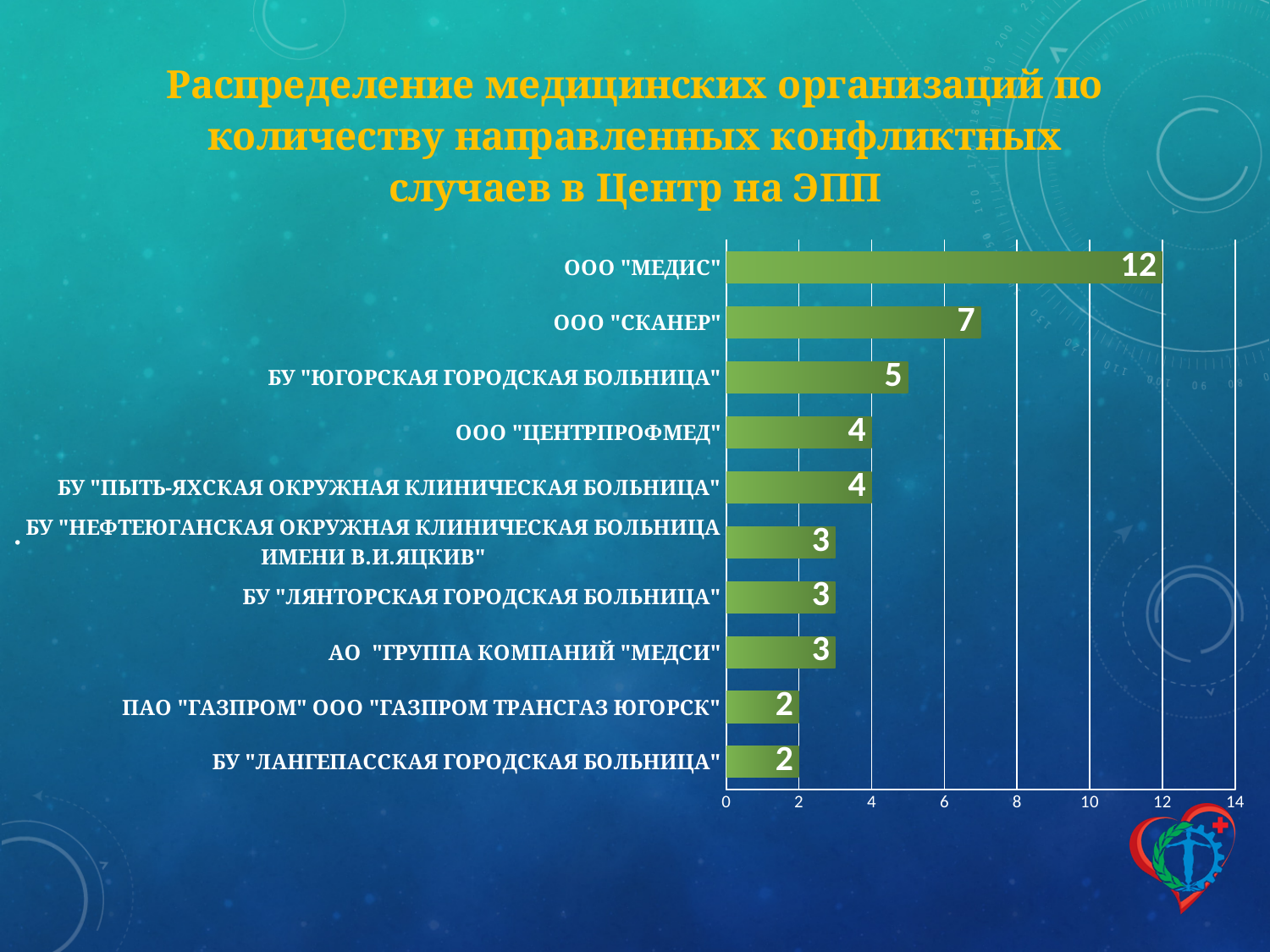
What is the value for ООО "СКАНЕР"? 7 What is the highest value shown on the x axis? 14 Is the value for ООО "СКАНЕР" greater or less than 6? greater What is the difference between the values for БУ "ЮГОРСКАЯ ГОРОДСКАЯ БОЛЬНИЦА" and БУ "ЛАНГЕПАССКАЯ ГОРОДСКАЯ БОЛЬНИЦА"? 3 How many organisations are shown in the chart? 10 Which organisation has the highest value? ООО "МЕДИС" What is the value for ООО "МЕДИС"? 12 What is the difference between the values for ООО "МЕДИС" and ООО "СКАНЕР"? 5 What is the value for БУ "ЮГОРСКАЯ ГОРОДСКАЯ БОЛЬНИЦА"? 5 Which is larger, the value for ООО "ЦЕНТРПРОФМЕД" or the value for АО "ГРУППА КОМПАНИЙ "МЕДСИ"? ООО "ЦЕНТРПРОФМЕД" What is the value for ПАО "ГАЗПРОМ" ООО "ГАЗПРОМ ТРАНСГАЗ ЮГОРСК"? 2 What kind of chart is shown on the slide? bar chart